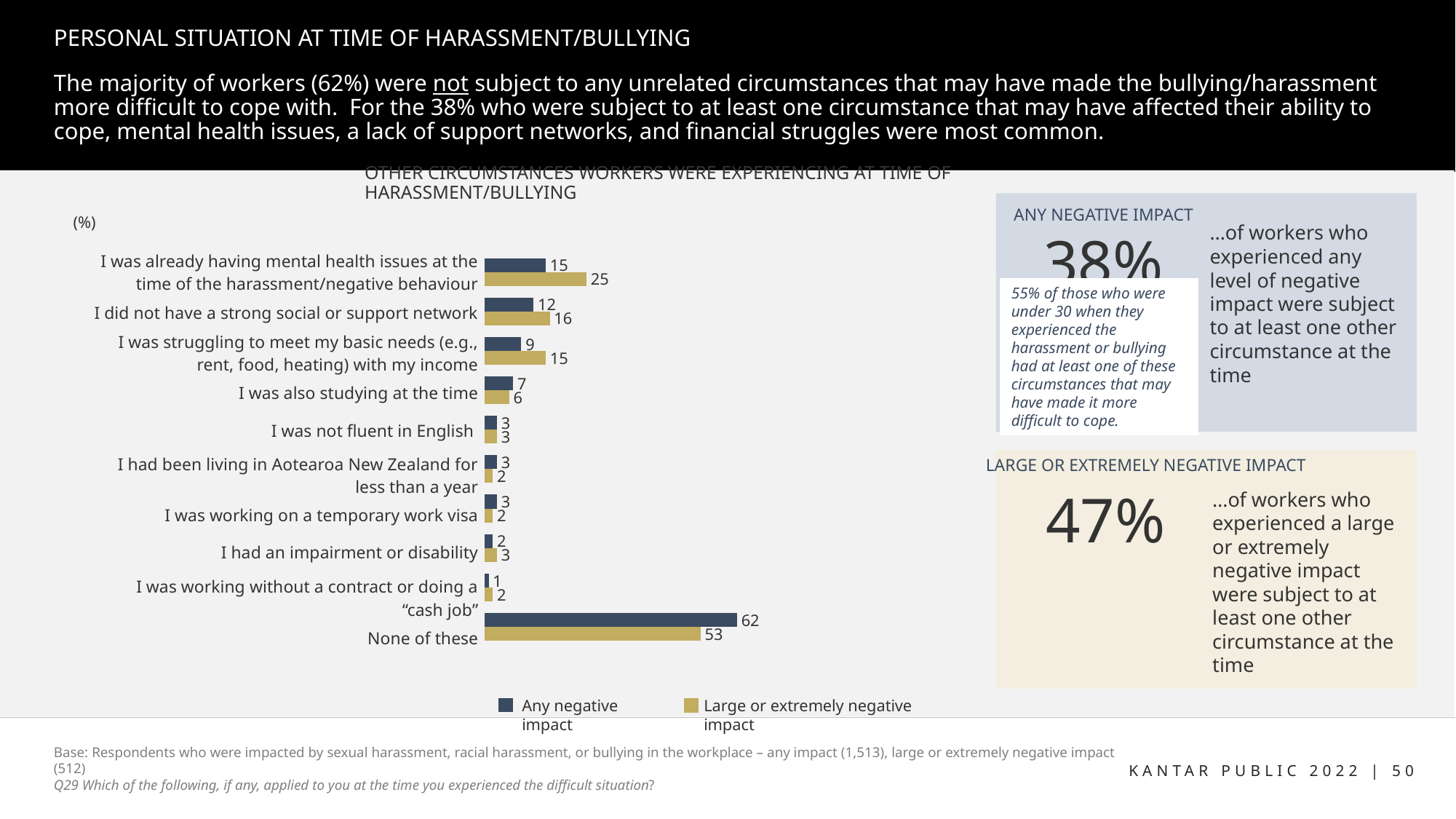
For "I was also studying at the time", which series has the larger value: Any negative impact or Large or extremely negative impact? Any negative impact How many series does the chart legend list? 2 What is the value for "I was already having mental health issues at the time of the harassment/negative behaviour" in the Large or extremely negative impact series? 25 Excluding "None of these", which category has the highest value in the Large or extremely negative impact series? I was already having mental health issues at the time of the harassment/negative behaviour What type of chart is shown on the slide? Bar chart Which category has the lowest value in the Any negative impact series? I was working without a contract or doing a "cash job" How many categories are shown in the bar chart? 10 What is the value for "None of these" in the Any negative impact series? 62 What is the title of the chart? Other circumstances workers were experiencing at time of harassment/bullying What is the difference between the Large or extremely negative impact and Any negative impact values for "I was struggling to meet my basic needs (e.g., rent, food, heating) with my income"? 6 What is the difference between the Any negative impact and Large or extremely negative impact values for "None of these"? 9 What is the value for "I did not have a strong social or support network" in the Any negative impact series? 12